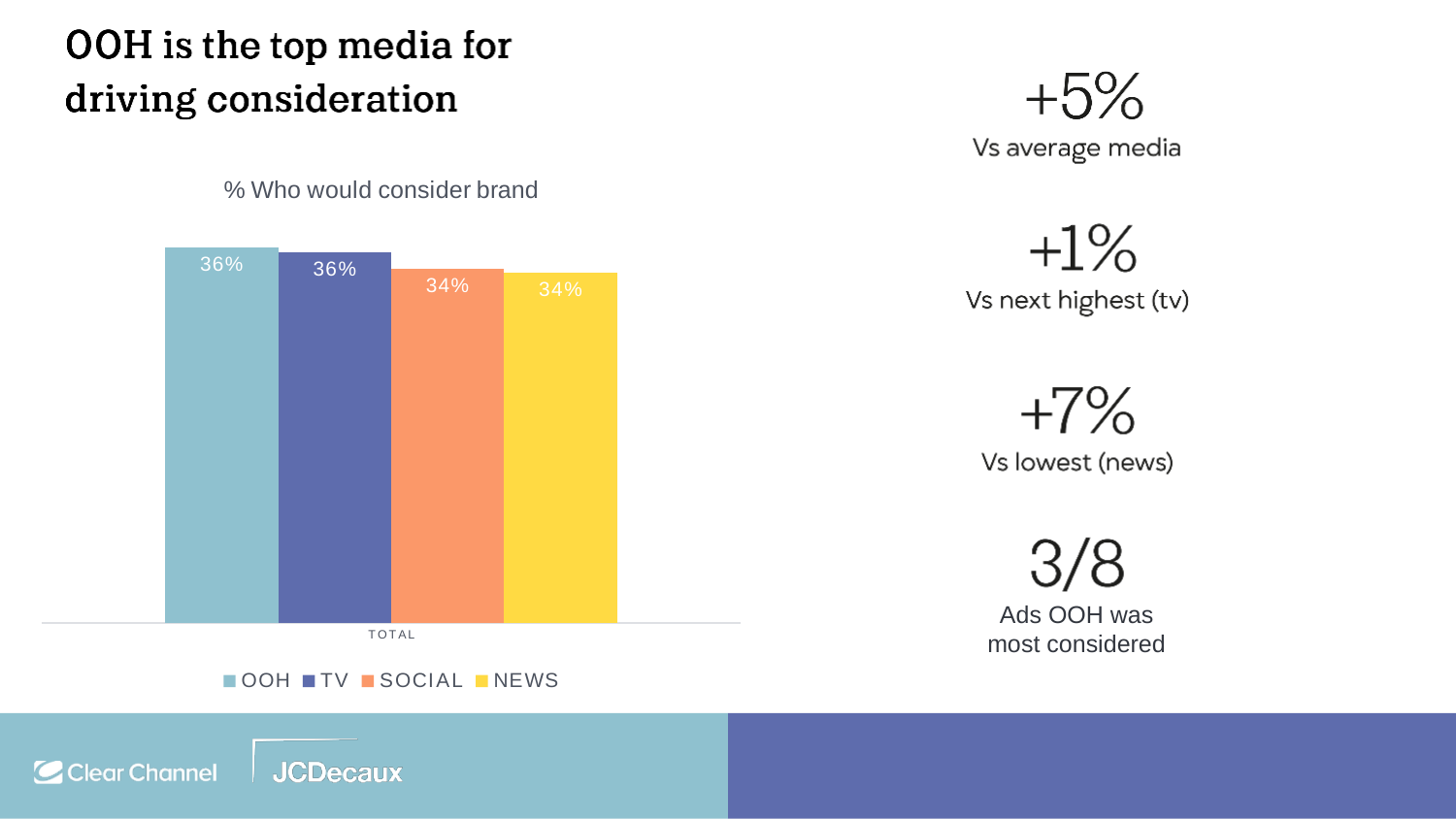
What kind of chart is shown on the slide? Bar chart How many categories are shown on the x axis of the chart? 1 What is the value for SOCIAL in the chart? 34% What is the value for TV in the chart? 36% What is the difference between the value for OOH and the value for NEWS? 2 percentage points Which is larger, the value for OOH or the value for SOCIAL? OOH What is the label of the single category on the x axis? TOTAL Which is larger, the value for NEWS or the value for TV? TV What is the value for OOH in the chart? 36% What is the title of the chart? % Who would consider brand What is the value for NEWS in the chart? 34% How many series does the chart legend list? 4